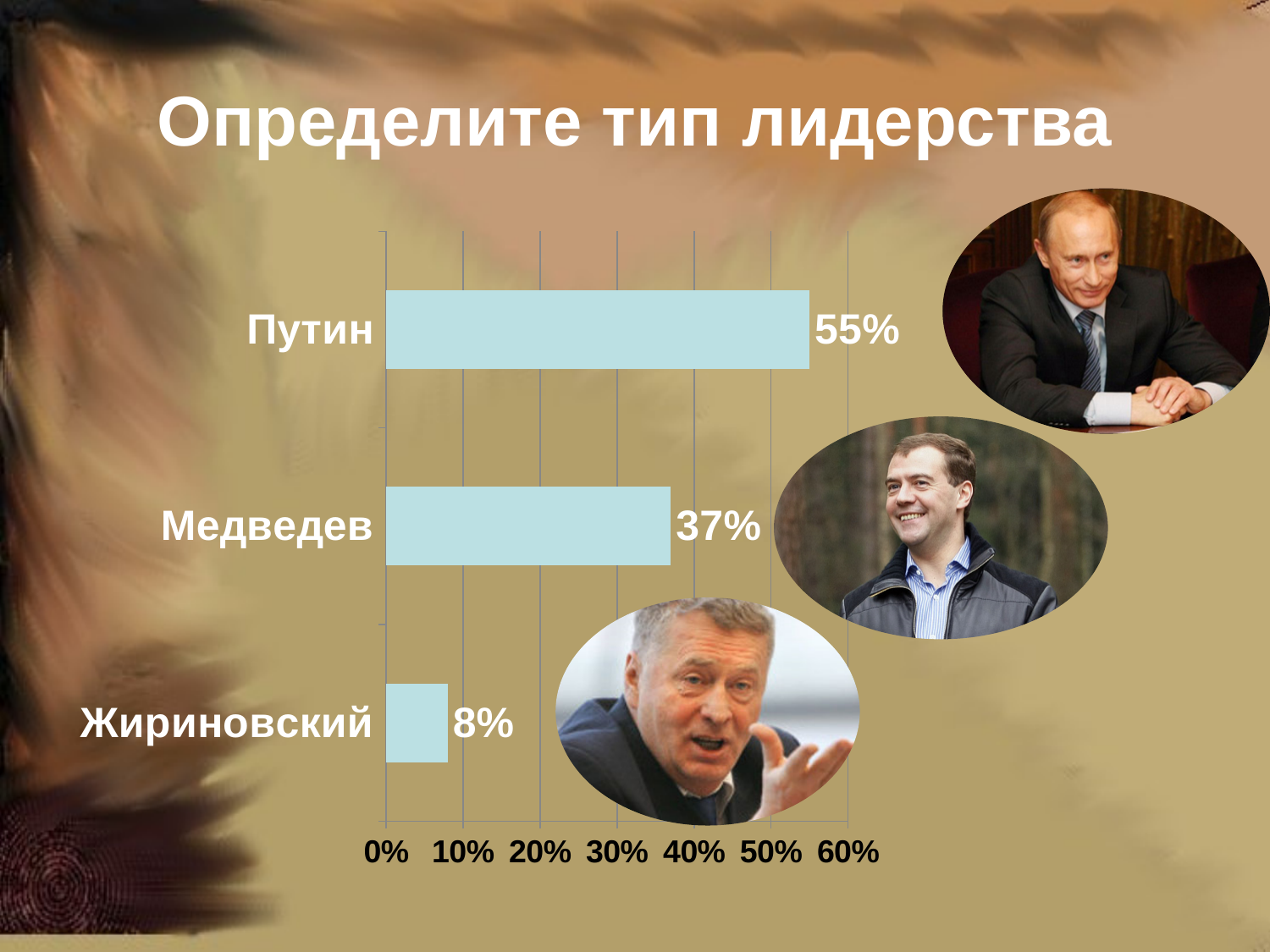
Which category has the lowest value? Жириновский How many categories are shown in the chart? 3 What is the title of the slide? Определите тип лидерства What kind of chart is shown on the slide? bar chart What is the difference between the values for Медведев and Жириновский? 29% What is the value for Медведев? 37% What is the difference between the values for Путин and Медведев? 18% Which category has the highest value? Путин What is the value for Жириновский? 8% Is the value for Путин greater or less than 50%? greater Which is larger, the value for Медведев or the value for Жириновский? Медведев What is the value for Путин? 55%